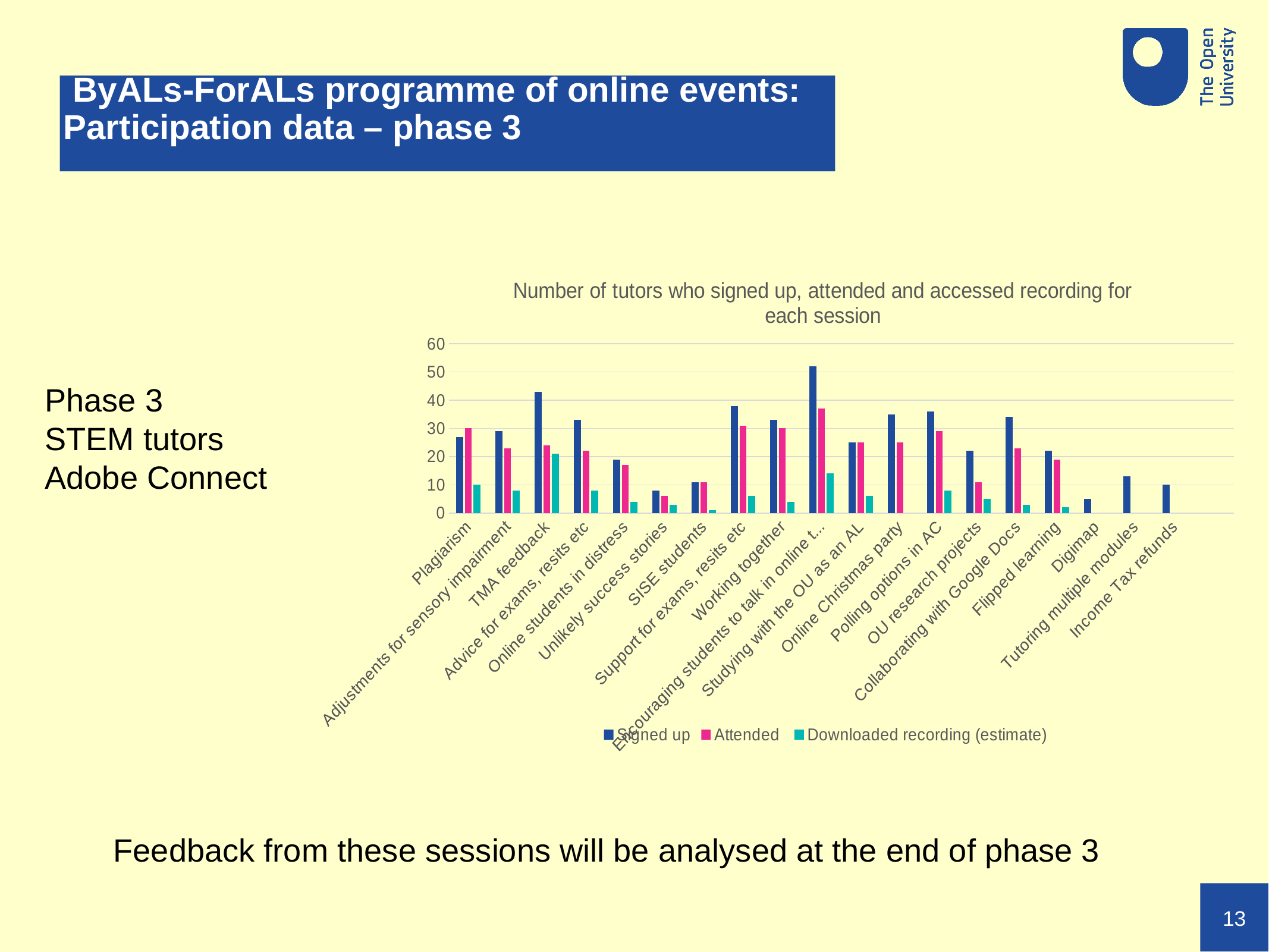
Is the 'Signed up' value for Plagiarism greater or less than 30? less Is the 'Signed up' value for TMA feedback greater or less than 40? greater Which session has the lowest 'Signed up' value? Digimap What kind of chart is shown on the slide? bar chart Which has the larger 'Signed up' value: TMA feedback or Plagiarism? TMA feedback How many series does the chart legend list? 3 Is the 'Attended' value for Online Christmas party greater or less than 20? greater Which session has the highest 'Signed up' value? Encouraging students to talk in online t... Which session has the highest 'Downloaded recording (estimate)' value? TMA feedback How many sessions (categories) are shown on the x axis of the chart? 19 What is the title of the chart? Number of tutors who signed up, attended and accessed recording for each session